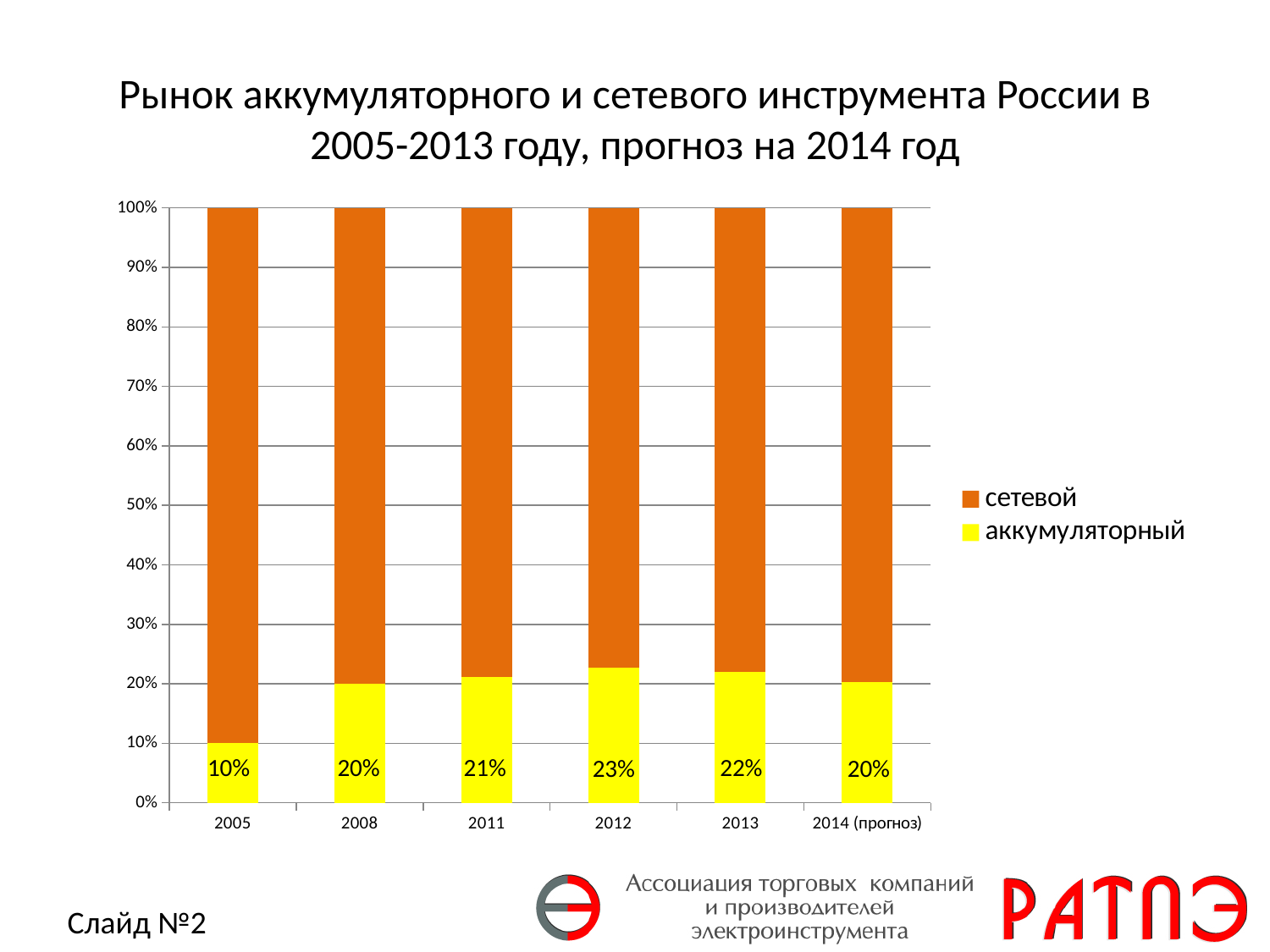
What is the difference between the аккумуляторный share in 2012 and in 2005? 13% Is the value for сетевой in 2005 greater or less than 80%? greater What kind of chart is shown on the slide? stacked bar chart In which year is the аккумуляторный share the lowest? 2005 What is the value for аккумуляторный in 2005? 10% What is the value for аккумуляторный in 2012? 23% How many years (categories) are shown on the x axis? 6 How many series does the legend list? 2 What is the value for аккумуляторный in 2014 (прогноз)? 20% Which colour represents сетевой in the chart? orange Which is larger, the аккумуляторный share in 2013 or in 2011? 2013 In which year is the аккумуляторный share the highest? 2012